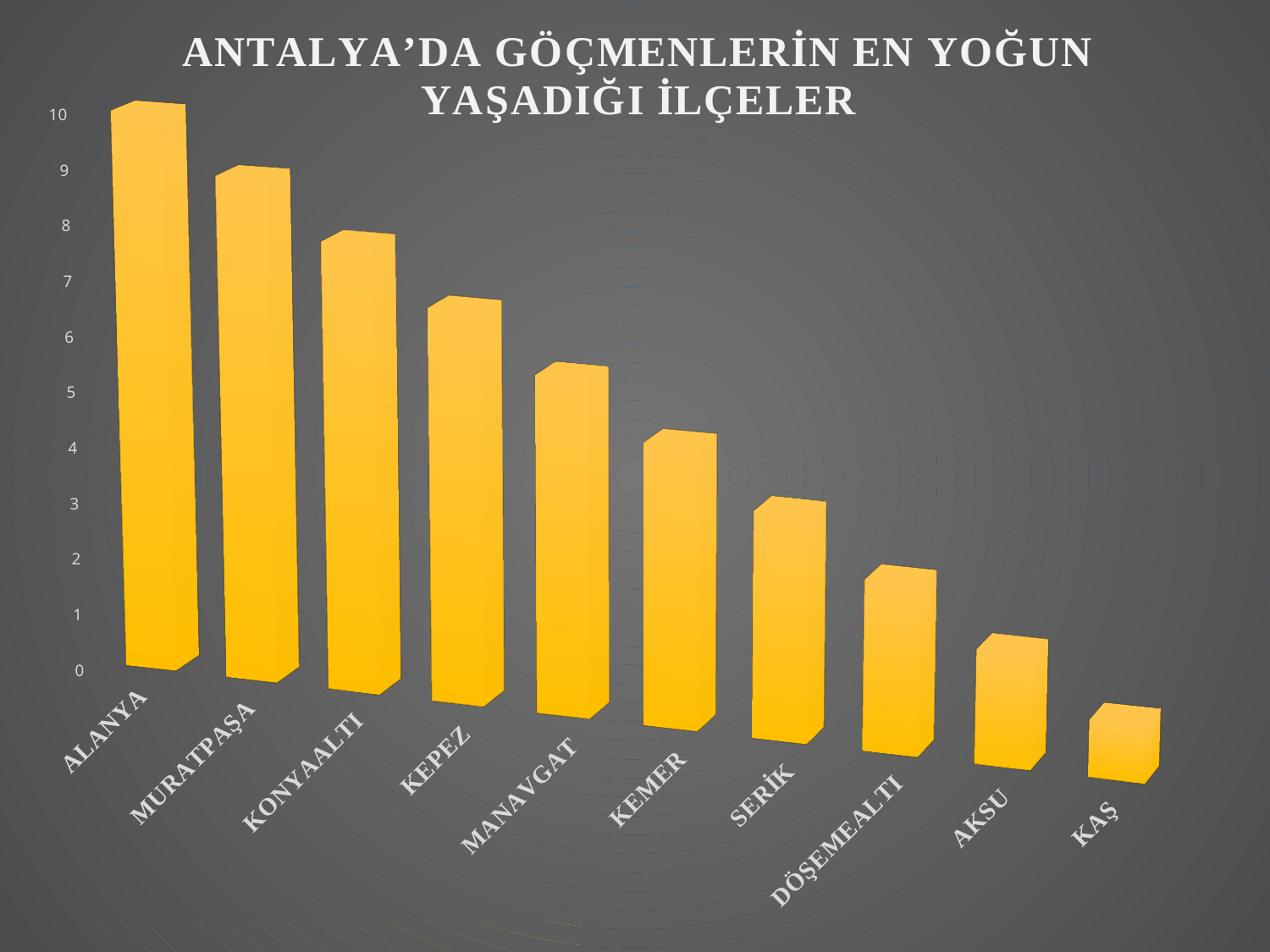
Is the value for KEMER greater or less than 3? greater How many districts (categories) are shown on the chart? 10 What is the title of the chart? ANTALYA'DA GÖÇMENLERİN EN YOĞUN YAŞADIĞI İLÇELER Which has the larger value, SERİK or AKSU? SERİK Which has the larger value, KONYAALTI or MANAVGAT? KONYAALTI Is the value for KAŞ greater or less than 2? less What kind of chart is shown on the slide? bar chart Is the value for ALANYA greater or less than 8? greater Which district has the lowest bar? KAŞ Which district has the highest bar? ALANYA Do the bar values rise or fall moving from left to right along the x axis? fall